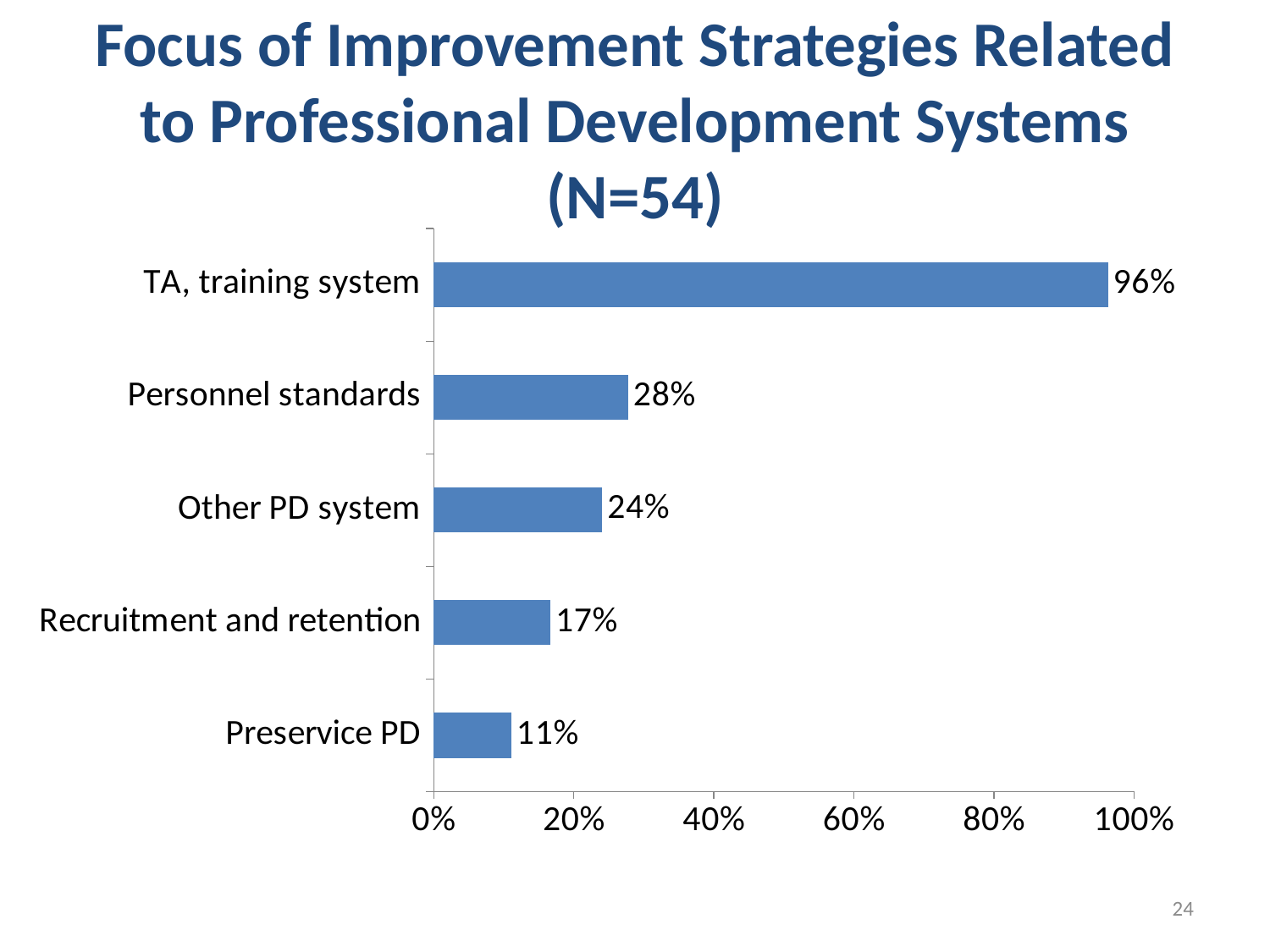
What is the value for Personnel standards? 28% Which category has the lowest value? Preservice PD How many categories are shown in the chart? 5 Which is larger, the value for Other PD system or the value for Recruitment and retention? Other PD system Is the value for Personnel standards greater or less than 40%? less What is the value for Other PD system? 24% What is the difference between the values for TA, training system and Personnel standards? 68% What is the value for Recruitment and retention? 17% Which category has the highest value? TA, training system What kind of chart is shown on the slide? bar chart What is the value for Preservice PD? 11% What is the value for TA, training system? 96%